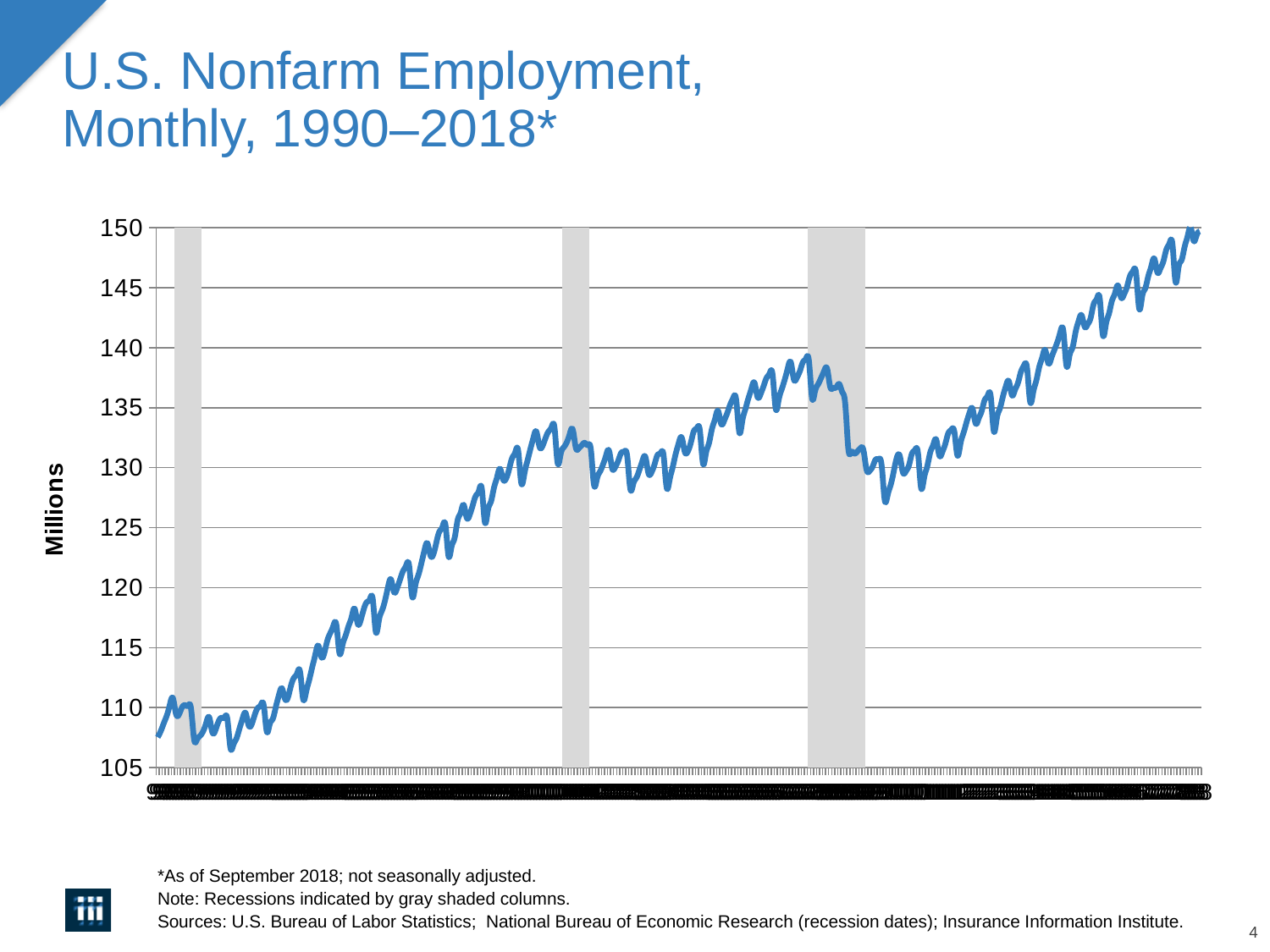
What is the title of the chart? U.S. Nonfarm Employment, Monthly, 1990–2018* What is the label on the vertical axis of the chart? Millions How many lines are plotted on the chart? 1 What is the highest value shown on the vertical axis? 150 What kind of chart is shown on the slide? line chart Is the value at the right end of the line (the most recent month) greater or less than 145? greater Is the value at the left end of the line (the earliest month) greater or less than 115? less Overall, does the line rise or fall from the left of the chart to the right? rise Is the lowest point of the line greater or less than 110? less Is the value at the right end of the line larger or smaller than the value at the left end? larger